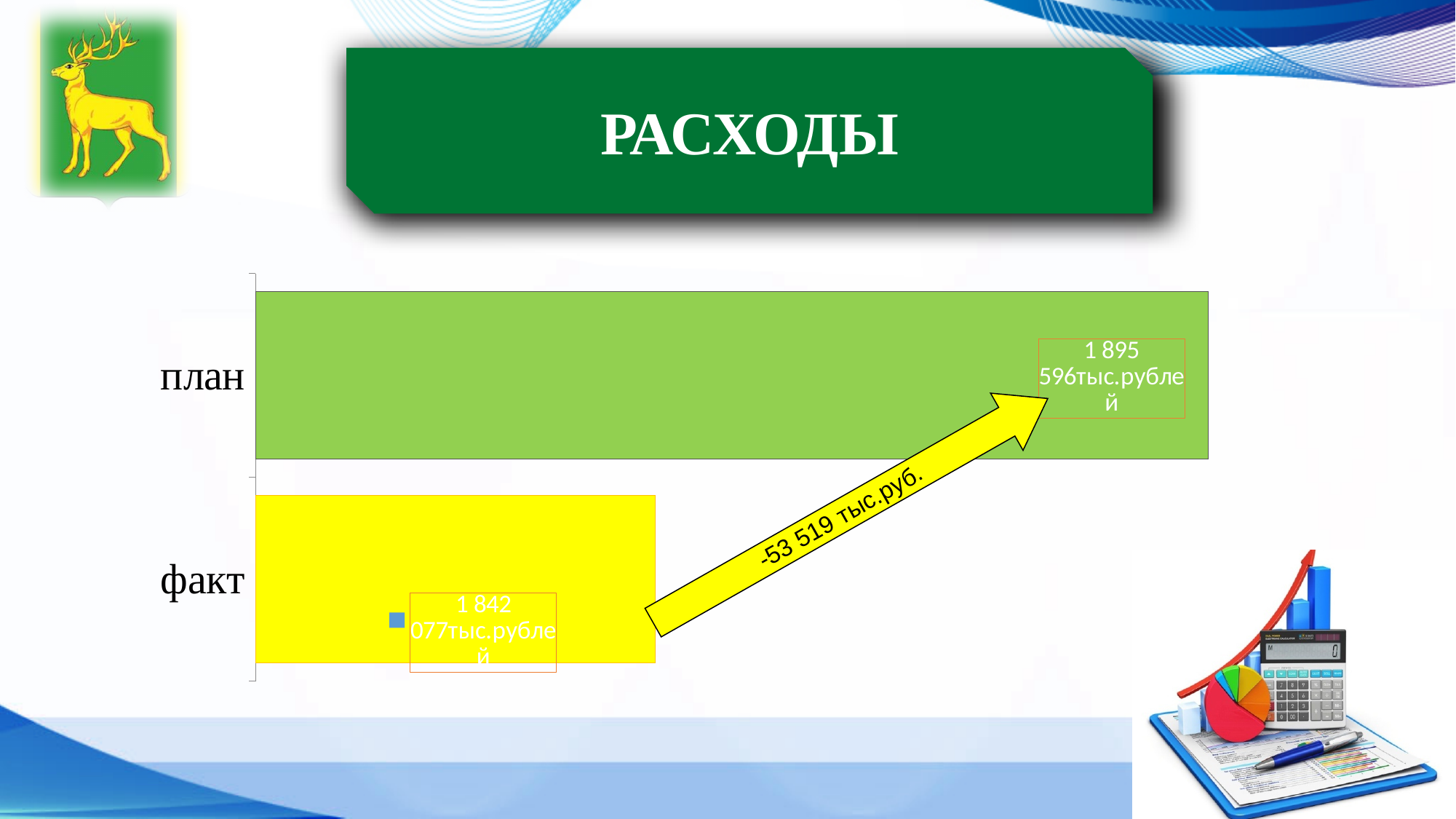
What is the value shown for план? 1 895 596 тыс.рублей What colour is the bar for факт? yellow What is the title shown above the chart? РАСХОДЫ Which category has the highest value? план What is the value shown for факт? 1 842 077 тыс.рублей What kind of chart is shown on the slide? bar chart Which category has the lowest value? факт How many categories are plotted in the chart? 2 Which category has the higher value, план or факт? план What difference between план and факт is printed on the arrow? -53 519 тыс.руб.